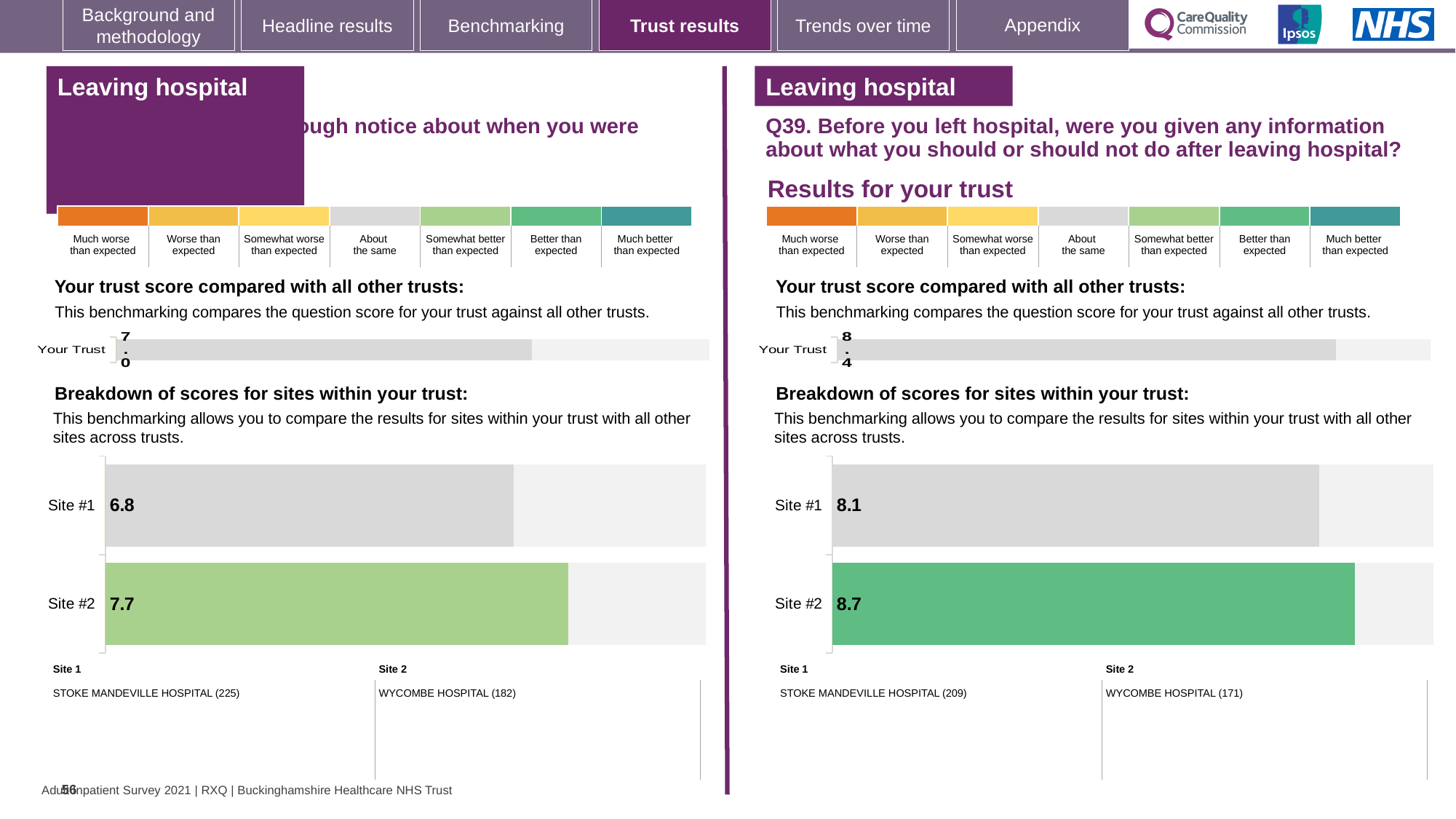
On the left-hand side of the slide, what is the score shown for Site #2 in the breakdown of scores for sites within your trust? 7.7 How many sites are shown in the breakdown of scores chart on the right-hand side of the slide (Q39)? 2 On the right-hand side of the slide (Q39), what is the score shown for Site #2 in the breakdown of scores for sites within your trust? 8.7 On the right-hand side of the slide (Q39), what is the score shown for Site #1 in the breakdown of scores for sites within your trust? 8.1 On the right-hand side of the slide (Q39), what is the difference between the Site #2 and Site #1 scores in the site breakdown chart? 0.6 On the right-hand side of the slide (Q39), what is the 'Your Trust' score in the trust score comparison chart? 8.4 On the left-hand side of the slide, which site has the higher score in the breakdown of scores for sites within your trust? Site #2 On the right-hand side of the slide (Q39), which site has the lower score in the breakdown of scores for sites within your trust? Site #1 On the left-hand side of the slide, what is the difference between the Site #2 and Site #1 scores in the site breakdown chart? 0.9 On the left-hand side of the slide, what is the 'Your Trust' score in the trust score comparison chart? 7.0 On the left-hand side of the slide, what is the score shown for Site #1 in the breakdown of scores for sites within your trust? 6.8 What type of chart is used for the breakdown of scores for sites within your trust on the left-hand side of the slide? Bar chart